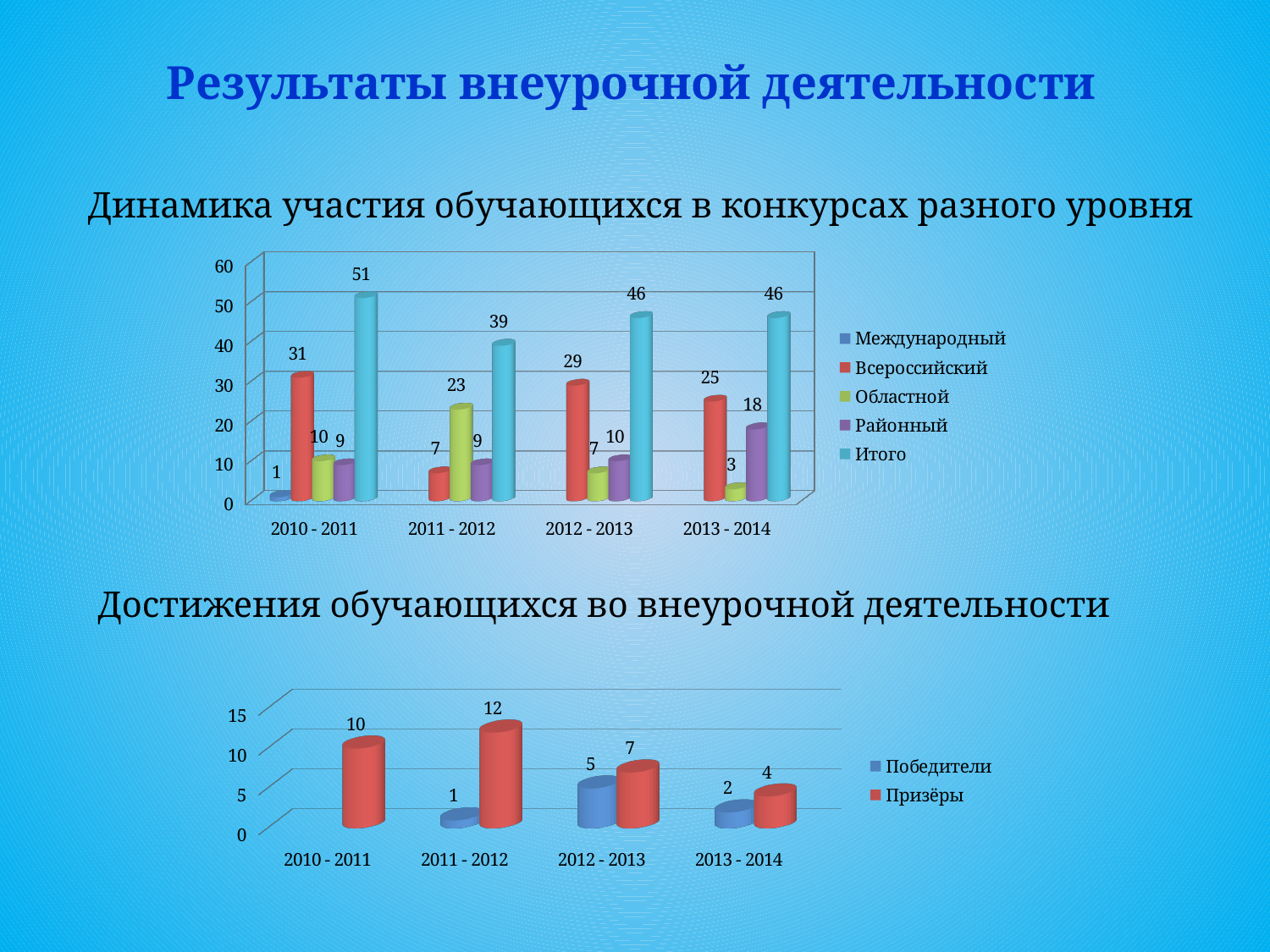
In the top chart (Динамика участия обучающихся в конкурсах разного уровня), what is the value for Всероссийский in 2010 - 2011? 31 How many series does the legend of the top chart list? 5 In the bottom chart, which year has the lowest Призёры value? 2013 - 2014 What kind of chart is the bottom chart? bar chart In the top chart, which year has the highest Итого value? 2010 - 2011 In the top chart, what is the value for Итого in 2011 - 2012? 39 In the bottom chart, what is the value for Победители in 2012 - 2013? 5 In the bottom chart (Достижения обучающихся во внеурочной деятельности), what is the value for Призёры in 2011 - 2012? 12 In the top chart, what is the value for Областной in 2013 - 2014? 3 In the top chart, which is larger in 2011 - 2012: Областной or Всероссийский? Областной In the bottom chart, what is the difference between Призёры and Победители in 2013 - 2014? 2 In the top chart, what is the difference between Всероссийский and Районный in 2012 - 2013? 19